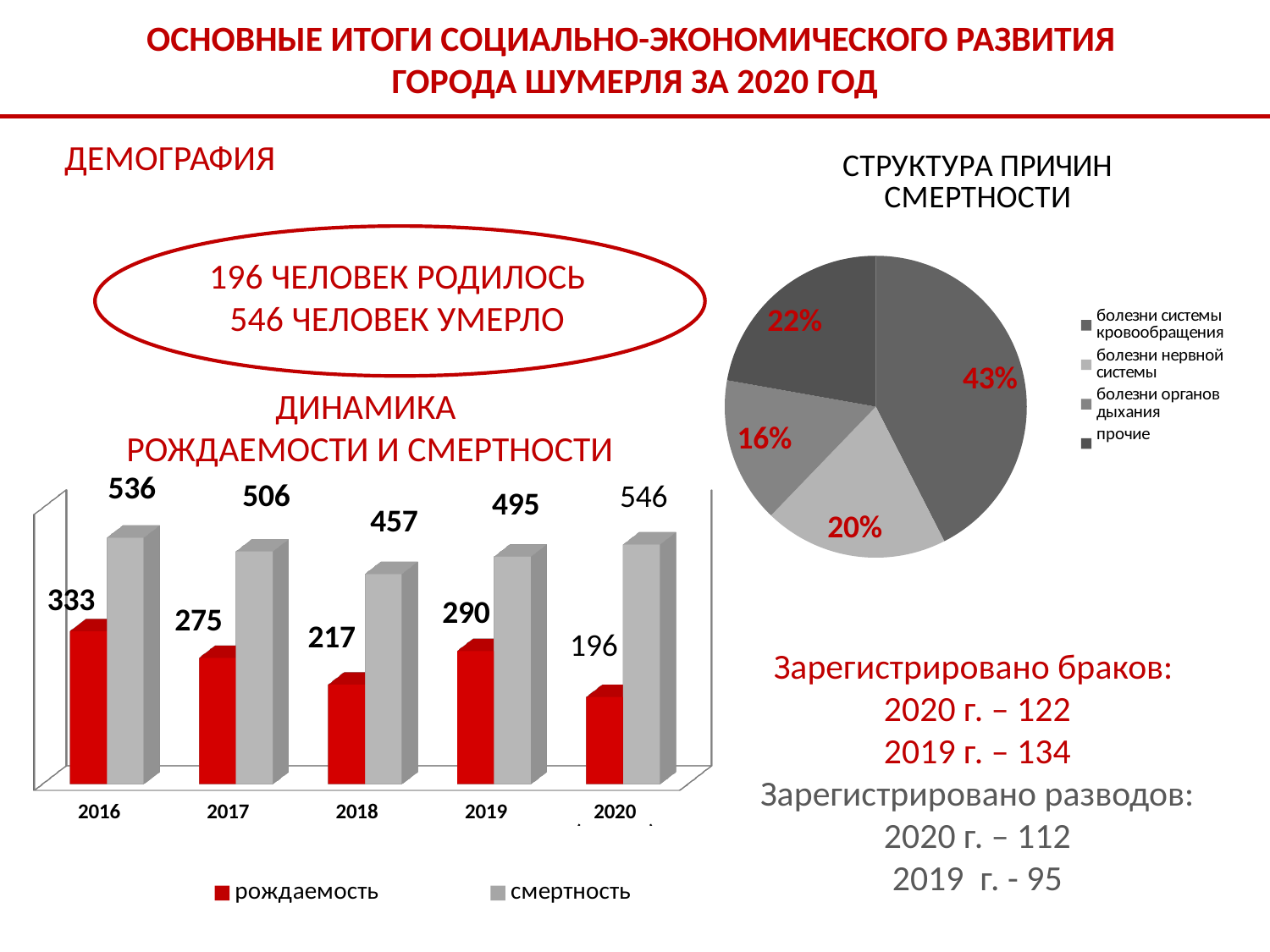
In the chart 'ДИНАМИКА РОЖДАЕМОСТИ И СМЕРТНОСТИ', which is larger: рождаемость in 2017 or рождаемость in 2019? 2019 In the chart 'ДИНАМИКА РОЖДАЕМОСТИ И СМЕРТНОСТИ', which year has the highest смертность? 2020 In the chart 'ДИНАМИКА РОЖДАЕМОСТИ И СМЕРТНОСТИ', which year has the lowest рождаемость? 2020 In the pie chart 'СТРУКТУРА ПРИЧИН СМЕРТНОСТИ', what share is shown for болезни системы кровообращения? 43% In the chart 'ДИНАМИКА РОЖДАЕМОСТИ И СМЕРТНОСТИ', what is the value of рождаемость for 2016? 333 How many years are shown on the x axis of the chart 'ДИНАМИКА РОЖДАЕМОСТИ И СМЕРТНОСТИ'? 5 In the chart 'ДИНАМИКА РОЖДАЕМОСТИ И СМЕРТНОСТИ', what is the value of смертность for 2018? 457 In the chart 'ДИНАМИКА РОЖДАЕМОСТИ И СМЕРТНОСТИ', what is the difference between смертность and рождаемость in 2020? 350 In the pie chart 'СТРУКТУРА ПРИЧИН СМЕРТНОСТИ', which category has the smallest share? болезни органов дыхания What kind of chart is 'ДИНАМИКА РОЖДАЕМОСТИ И СМЕРТНОСТИ'? bar chart How many series does the legend of the chart 'ДИНАМИКА РОЖДАЕМОСТИ И СМЕРТНОСТИ' list? 2 How many categories does the legend of the pie chart 'СТРУКТУРА ПРИЧИН СМЕРТНОСТИ' list? 4